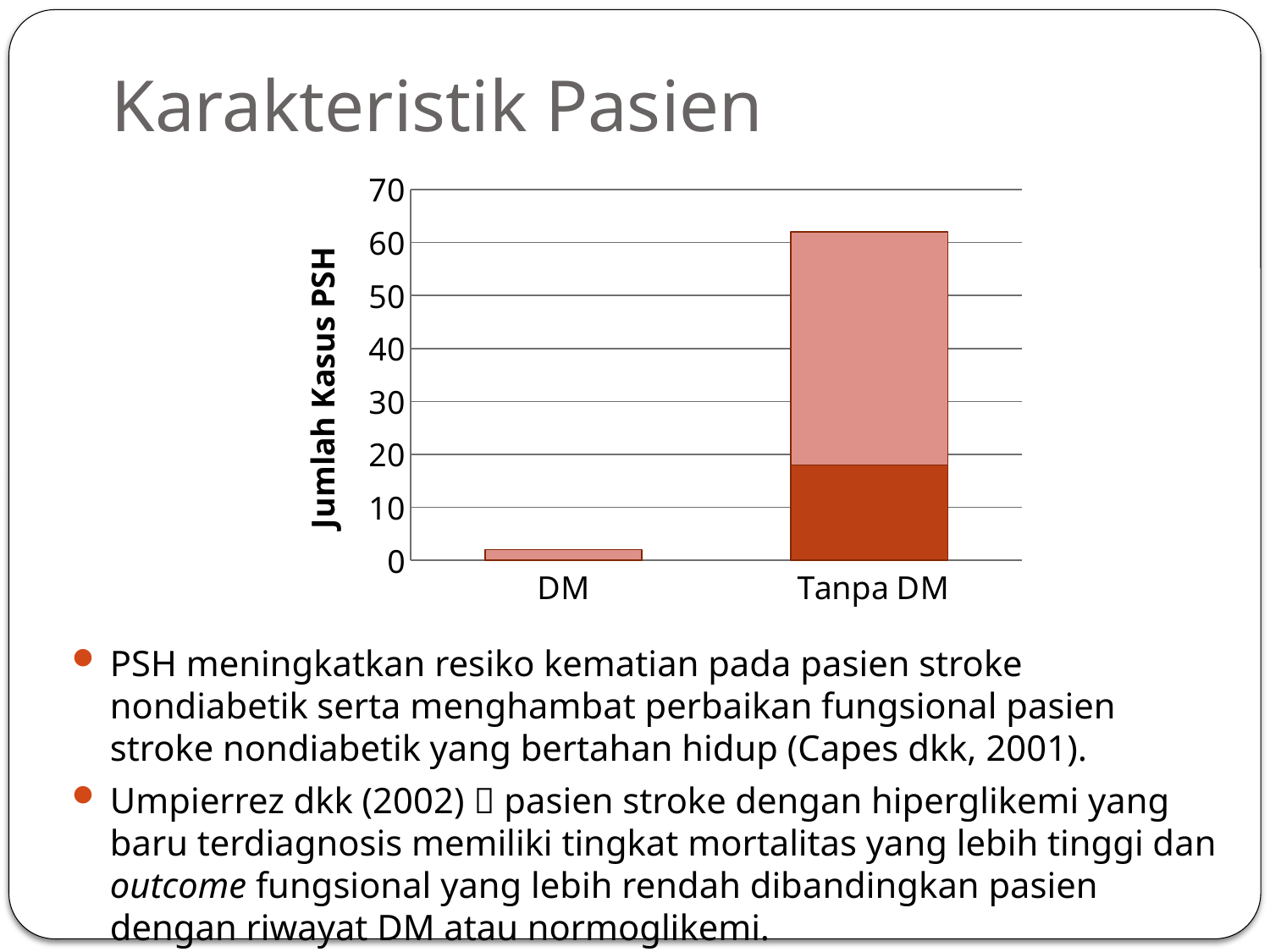
Which is larger: the bar for DM or the bar for Tanpa DM? Tanpa DM Which category has the highest total bar in the chart? Tanpa DM What is the highest value shown on the vertical axis of the chart? 70 What kind of chart is shown on the slide? bar chart Is the dark red (bottom) segment of the Tanpa DM bar greater or less than 10? greater Is the bar for DM greater or less than 10? less Is the dark red (bottom) segment of the Tanpa DM bar greater or less than 20? less What is the label of the vertical axis of the chart? Jumlah Kasus PSH Which category has the lowest total bar in the chart? DM How many categories are shown on the x axis of the chart? 2